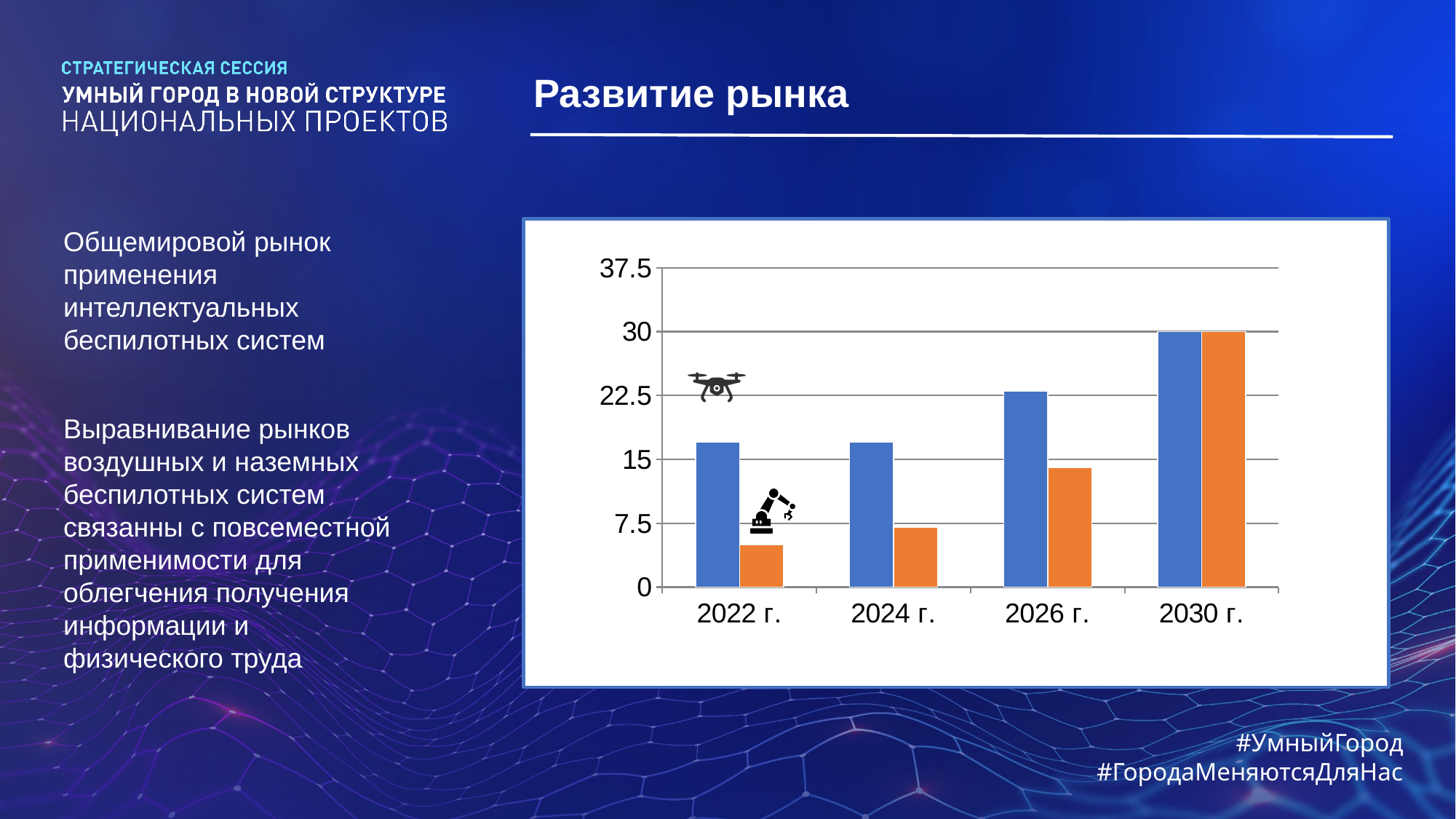
What is the value of the blue bar for 2030 г.? 30 Is the value of the blue bar for 2026 г. greater or less than 15? greater What is the title of the slide containing the chart? Развитие рынка What is the value of the orange bar for 2030 г.? 30 Is the value of the orange bar for 2022 г. greater or less than 7.5? less In 2022 г., which bar is larger, the blue one or the orange one? the blue one How many year categories are shown on the x axis of the chart? 4 For which year is the orange bar the lowest? 2022 г. Is the value of the orange bar for 2026 г. greater or less than 15? less Do the orange bars rise or fall from 2022 г. to 2030 г.? rise What kind of chart is shown on the slide? bar chart